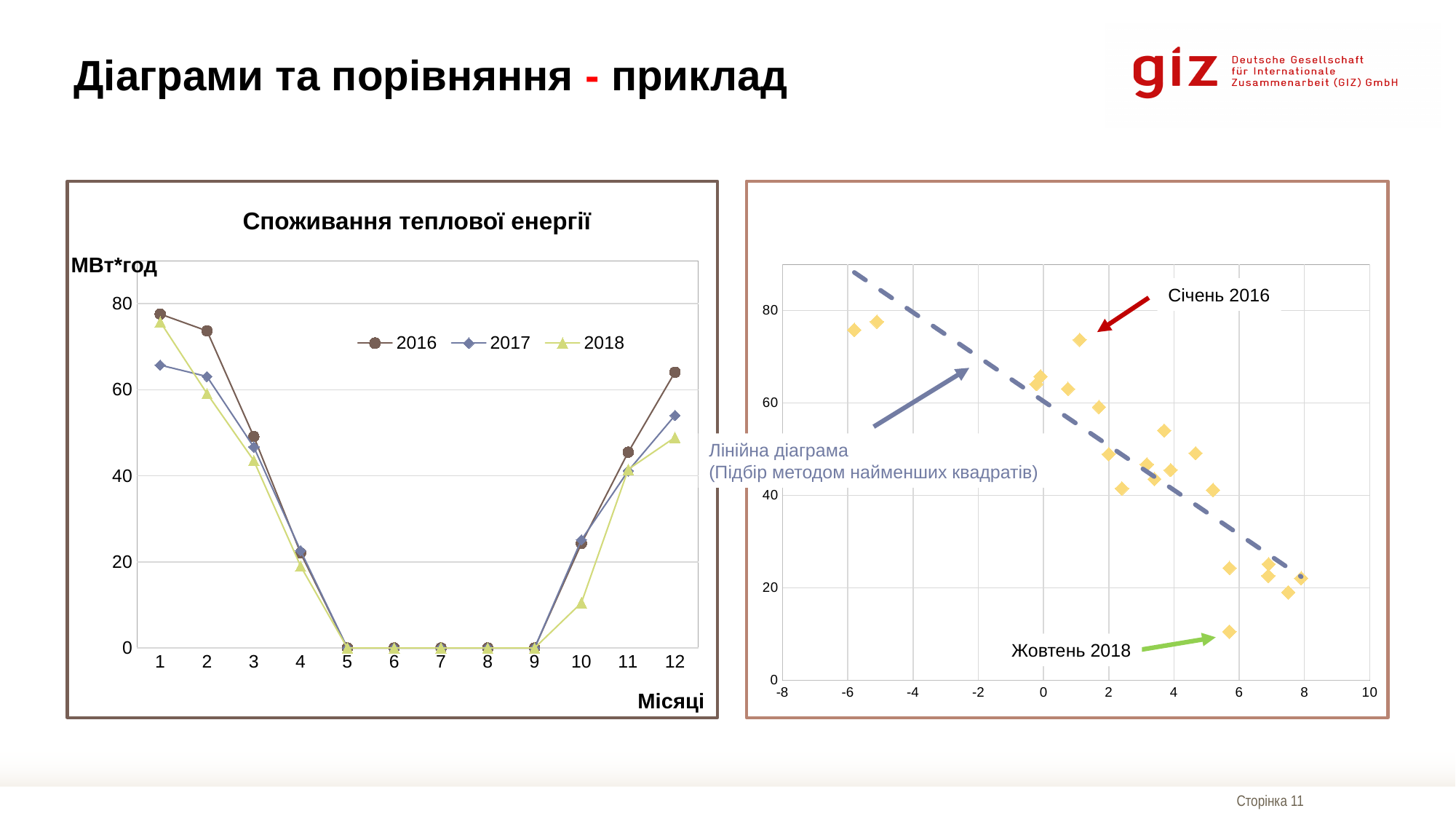
On the left chart 'Споживання теплової енергії', is the value for 2017 in month 1 greater or less than 60? greater On the left chart 'Споживання теплової енергії', what is the value for 2016 in month 7? 0 On the right chart, does the dashed fitted line rise or fall as x increases? fall On the left chart 'Споживання теплової енергії', which is larger in month 12: the value for 2016 or the value for 2018? 2016 On the left chart 'Споживання теплової енергії', how many series does the legend list? 3 On the left chart 'Споживання теплової енергії', do the values for 2016 rise or fall from month 1 to month 5? fall What kind of chart is the right chart? scatter chart On the right chart, is the value of the point labelled 'Жовтень 2018' greater or less than 20? less What kind of chart is the left chart 'Споживання теплової енергії'? line chart On the left chart 'Споживання теплової енергії', which month has the highest value for the 2016 series? 1 On the left chart 'Споживання теплової енергії', is the value for 2018 in month 10 greater or less than 20? less On the left chart 'Споживання теплової енергії', how many months are shown on the x axis? 12